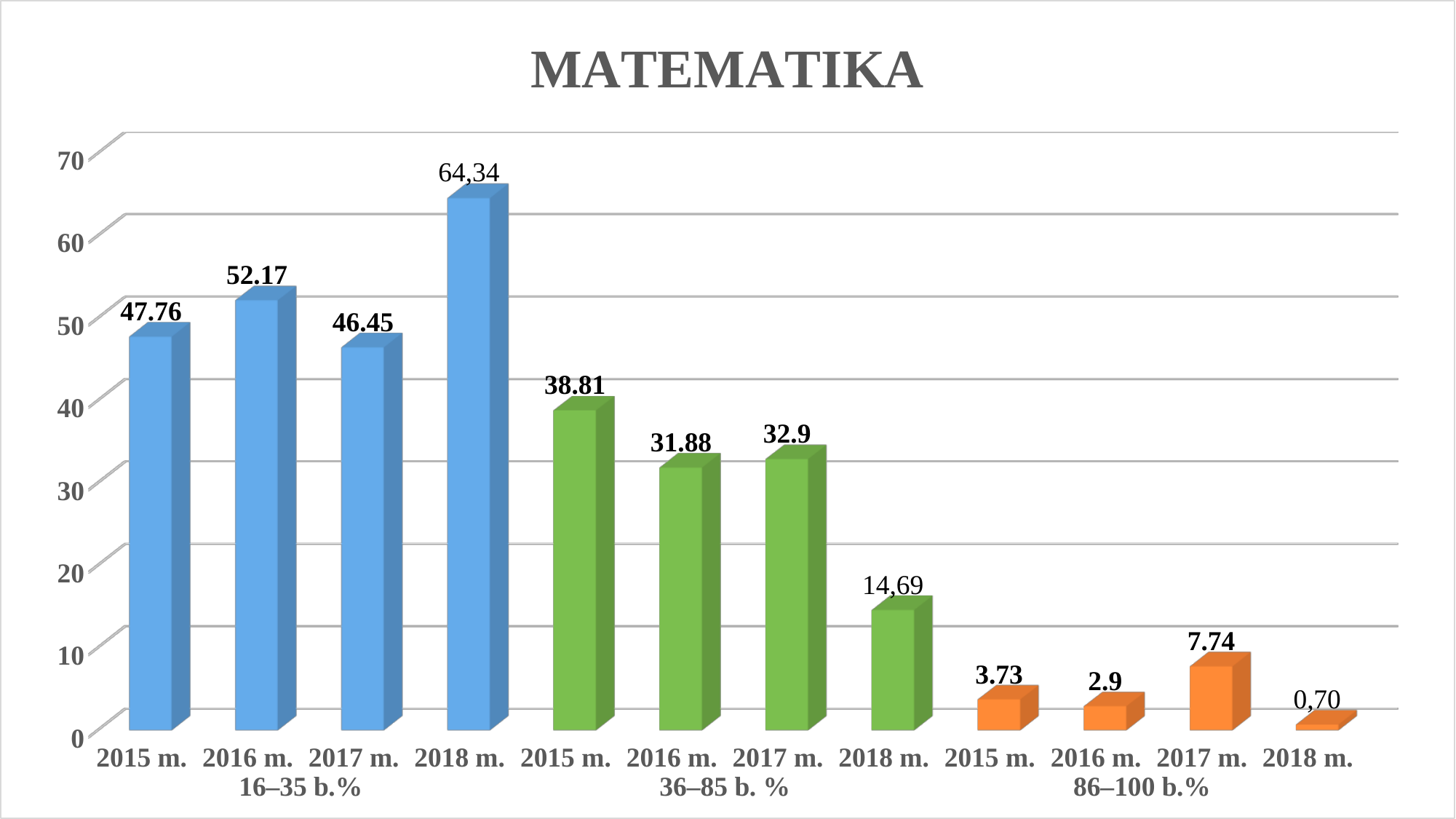
What is the title of the chart? MATEMATIKA What is the difference between the 2016 m. and 2015 m. values in the 16–35 b.% group? 4.41 Do the values in the 36–85 b. % group rise or fall from 2017 m. to 2018 m.? fall Which is larger in the 36–85 b. % group: the value for 2017 m. or the value for 2016 m.? 2017 m. Which bar has the lowest value on the chart? 2018 m. (86–100 b.%) Which bar has the highest value on the chart? 2018 m. (16–35 b.%) What kind of chart is shown on the slide? bar chart Is the value for 2015 m. in the 36–85 b. % group greater or less than 40? less What is the value for 2016 m. in the 36–85 b. % group? 31.88 What is the value for 2018 m. in the 16–35 b.% group? 64,34 How many bars are plotted on the chart? 12 What is the value for 2017 m. in the 86–100 b.% group? 7.74